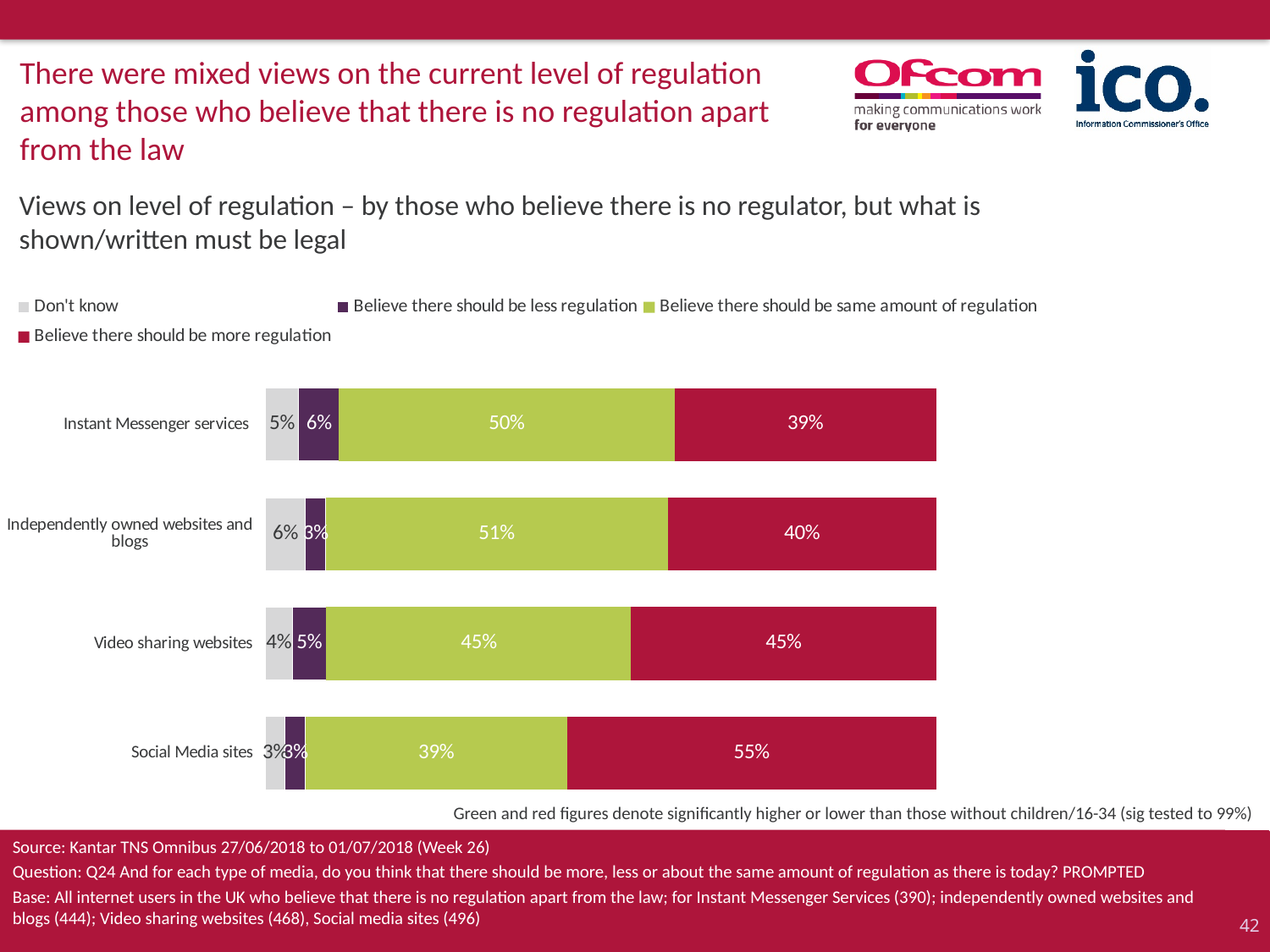
What percentage believe there should be less regulation for Video sharing websites? 5% Which series is shown in red in the chart? Believe there should be more regulation Which category has the lowest share believing there should be the same amount of regulation? Social Media sites What kind of chart is shown on the slide? Stacked bar chart Which is larger: the 'same amount of regulation' value for Instant Messenger services or for Video sharing websites? Instant Messenger services What percentage of respondents believe there should be more regulation for Social Media sites? 55% How many series does the legend list? 4 What percentage believe there should be the same amount of regulation for Independently owned websites and blogs? 51% What is the 'Don't know' value for Instant Messenger services? 5% How many media categories are plotted in the chart? 4 What is the difference between the 'more regulation' values for Social Media sites and Instant Messenger services? 16 percentage points Which category has the highest share believing there should be more regulation? Social Media sites